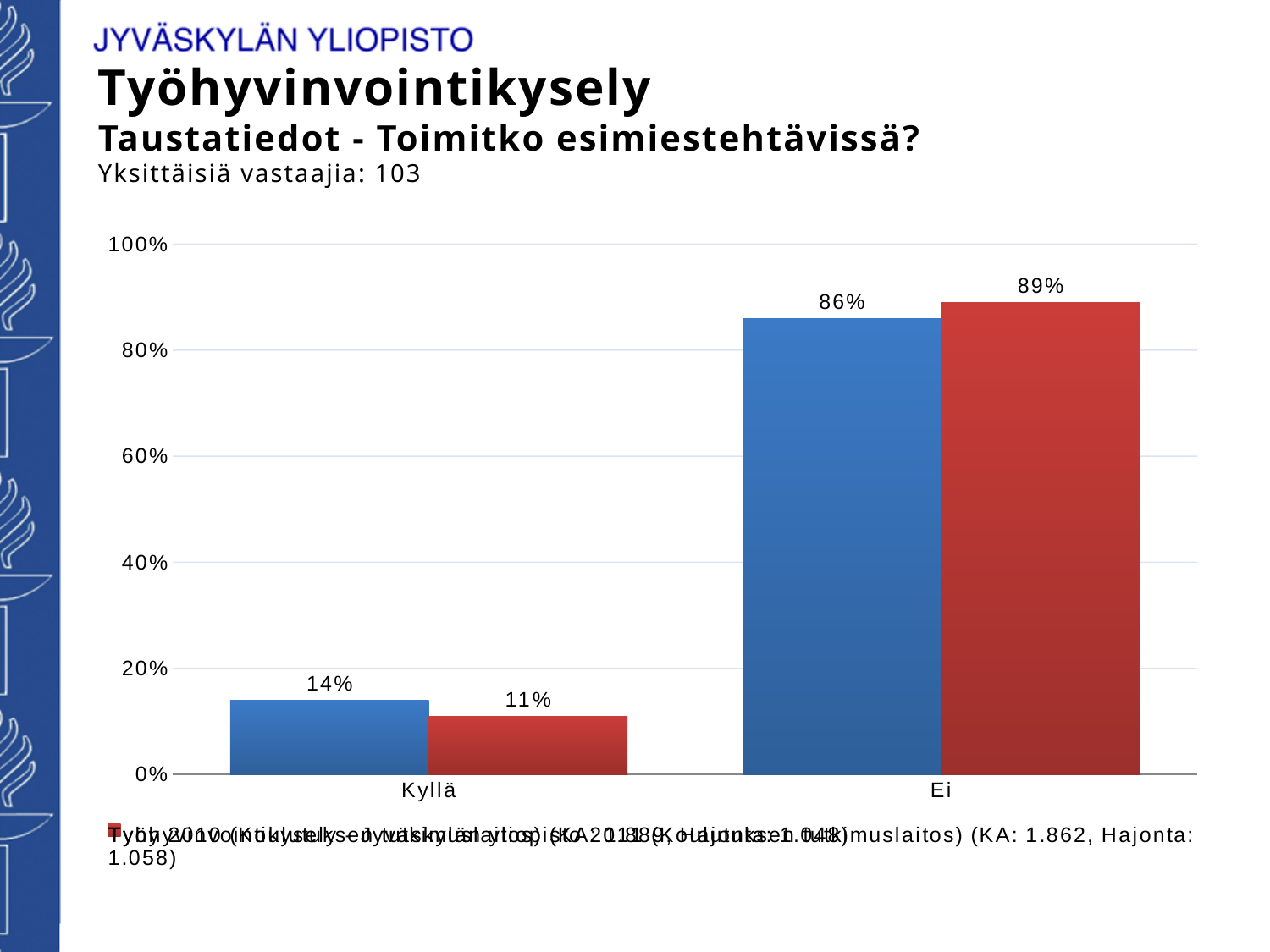
Which category has the higher blue bar, Kyllä or Ei? Ei How many categories are shown on the x axis? 2 Is the value of the blue bar for Ei greater or less than 80%? greater Which bar has the lowest value on the chart? The red bar for Kyllä (11%) What kind of chart is shown on the slide? Bar chart What is the value of the red bar for Kyllä? 11% What is the value of the blue bar for Ei? 86% What is the difference between the blue and red bars for Kyllä? 3 percentage points What is the difference between the red and blue bars for Ei? 3 percentage points What is the value of the red bar for Ei? 89% What is the value of the blue bar for Kyllä? 14% For Ei, which bar is larger, the blue or the red? Red